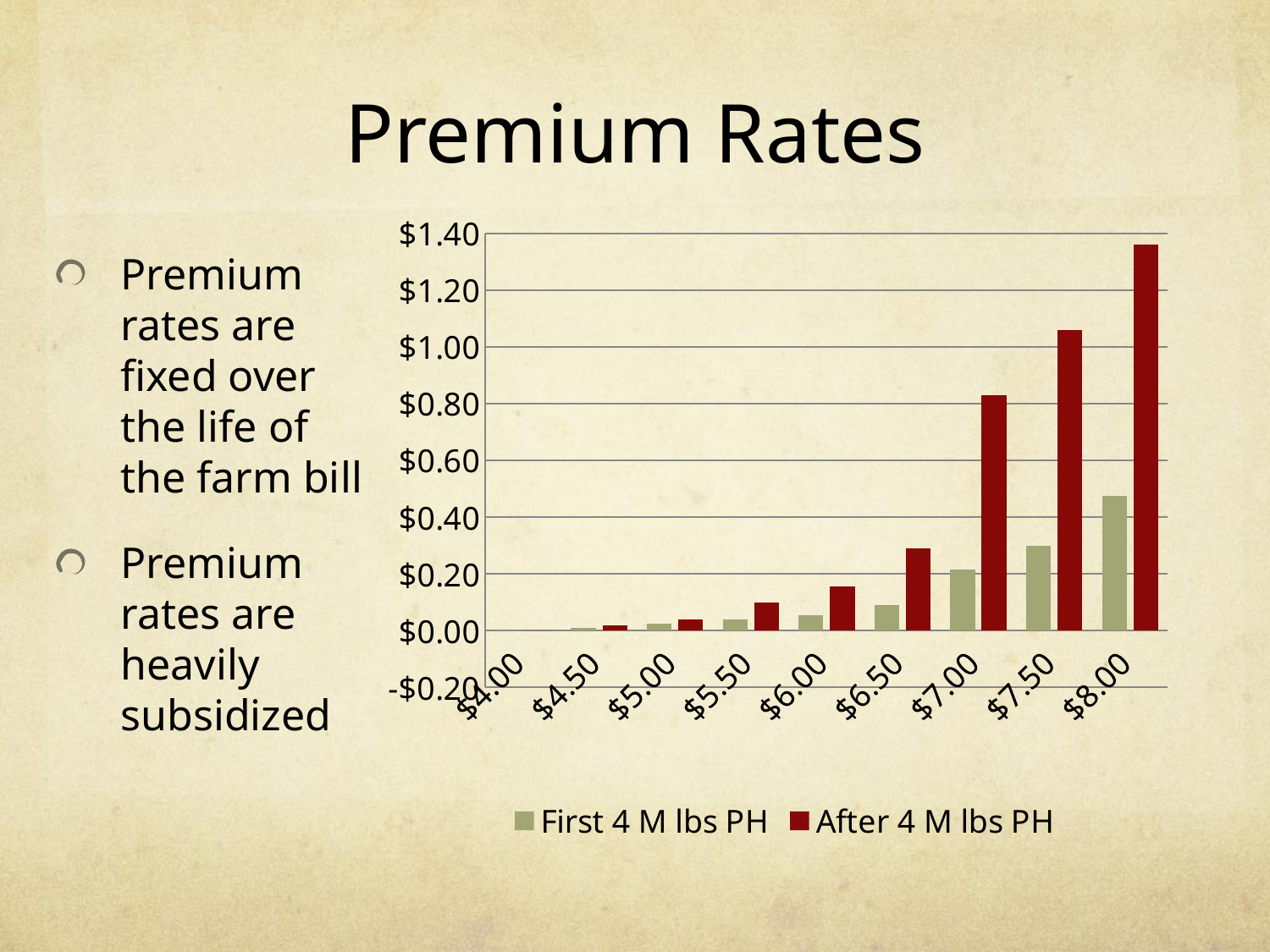
At $8.00, which series has the larger value, First 4 M lbs PH or After 4 M lbs PH? After 4 M lbs PH What kind of chart is shown on the slide? bar chart How many series does the legend list? 2 Do the values for After 4 M lbs PH rise or fall as the price increases along the x axis? rise Is the value for After 4 M lbs PH at $7.00 greater or less than $0.60? greater Which price category has the highest value for After 4 M lbs PH? $8.00 What colour are the bars for the After 4 M lbs PH series? dark red Is the value for After 4 M lbs PH at $8.00 greater or less than $1.20? greater Is the value for First 4 M lbs PH at $7.00 greater or less than $0.40? less How many price categories are shown on the x axis? 9 Which price category has the highest value for First 4 M lbs PH? $8.00